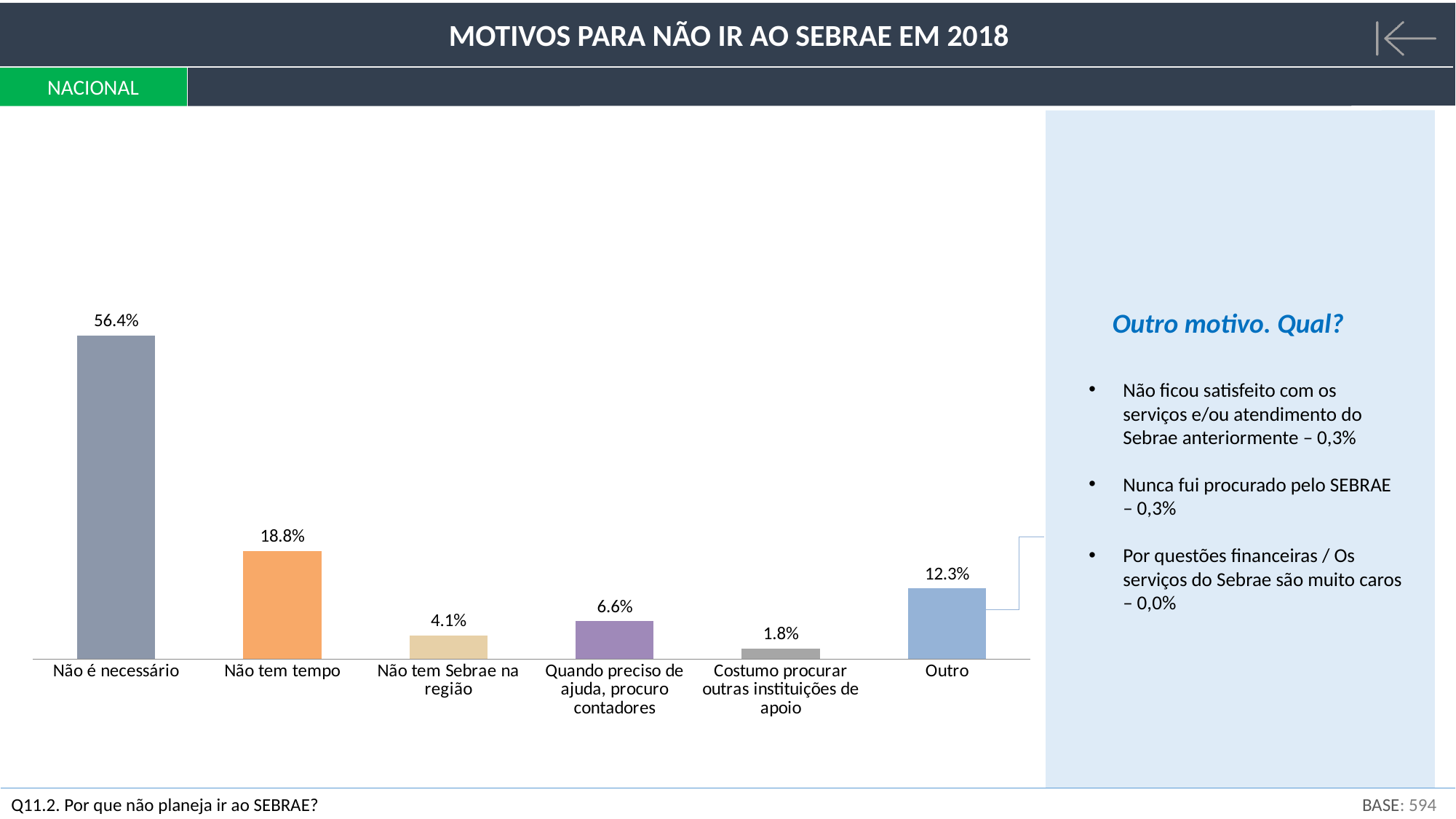
How many categories are shown in the chart? 6 What kind of chart is shown on the slide? Bar chart Which category has the lowest value? Costumo procurar outras instituições de apoio What is the difference between "Não é necessário" and "Não tem tempo"? 37.6 percentage points Which category has the highest value? Não é necessário What is the title of the slide? MOTIVOS PARA NÃO IR AO SEBRAE EM 2018 Which is larger, "Outro" or "Quando preciso de ajuda, procuro contadores"? Outro What is the difference between "Quando preciso de ajuda, procuro contadores" and "Não tem Sebrae na região"? 2.5 percentage points What is the value for "Costumo procurar outras instituições de apoio"? 1.8% What is the value for "Outro"? 12.3% What is the value for "Não é necessário"? 56.4% What is the value for "Não tem tempo"? 18.8%